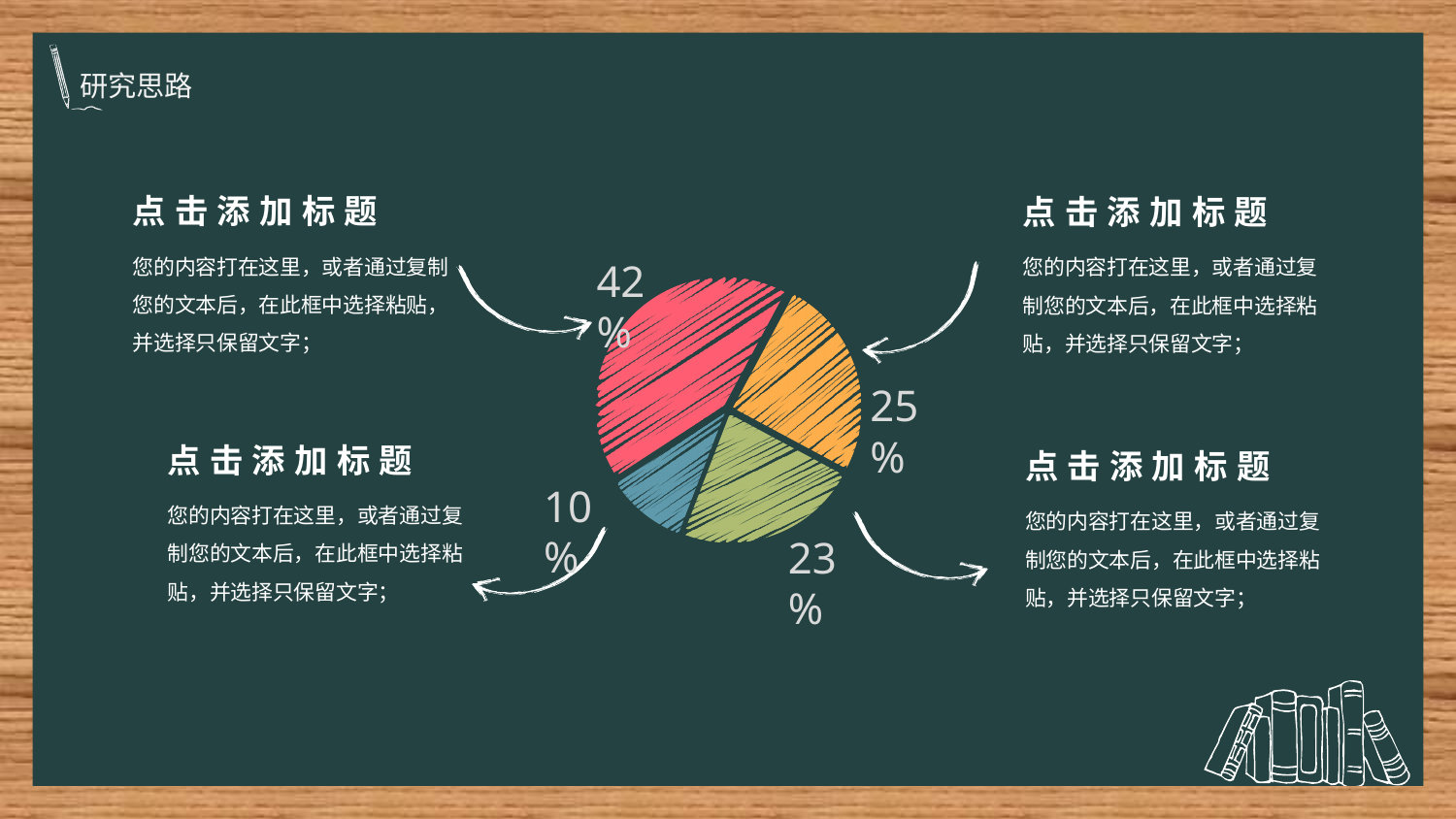
What kind of chart is shown on the slide? pie chart How many slices does the pie chart have? 4 What is the combined share of the orange and green slices of the pie chart? 48% What percentage is shown for the green slice of the pie chart? 23% What is the difference between the largest slice and the smallest slice of the pie chart? 32% Which slice of the pie chart is the largest? the red slice (42%) What colour is the slice labelled 42% in the pie chart? red What percentage is shown for the blue slice of the pie chart? 10% What percentage is shown for the red slice of the pie chart? 42% What percentage is shown for the orange slice of the pie chart? 25% Which slice of the pie chart is the smallest? the blue slice (10%) Which is larger in the pie chart, the orange slice or the green slice? the orange slice